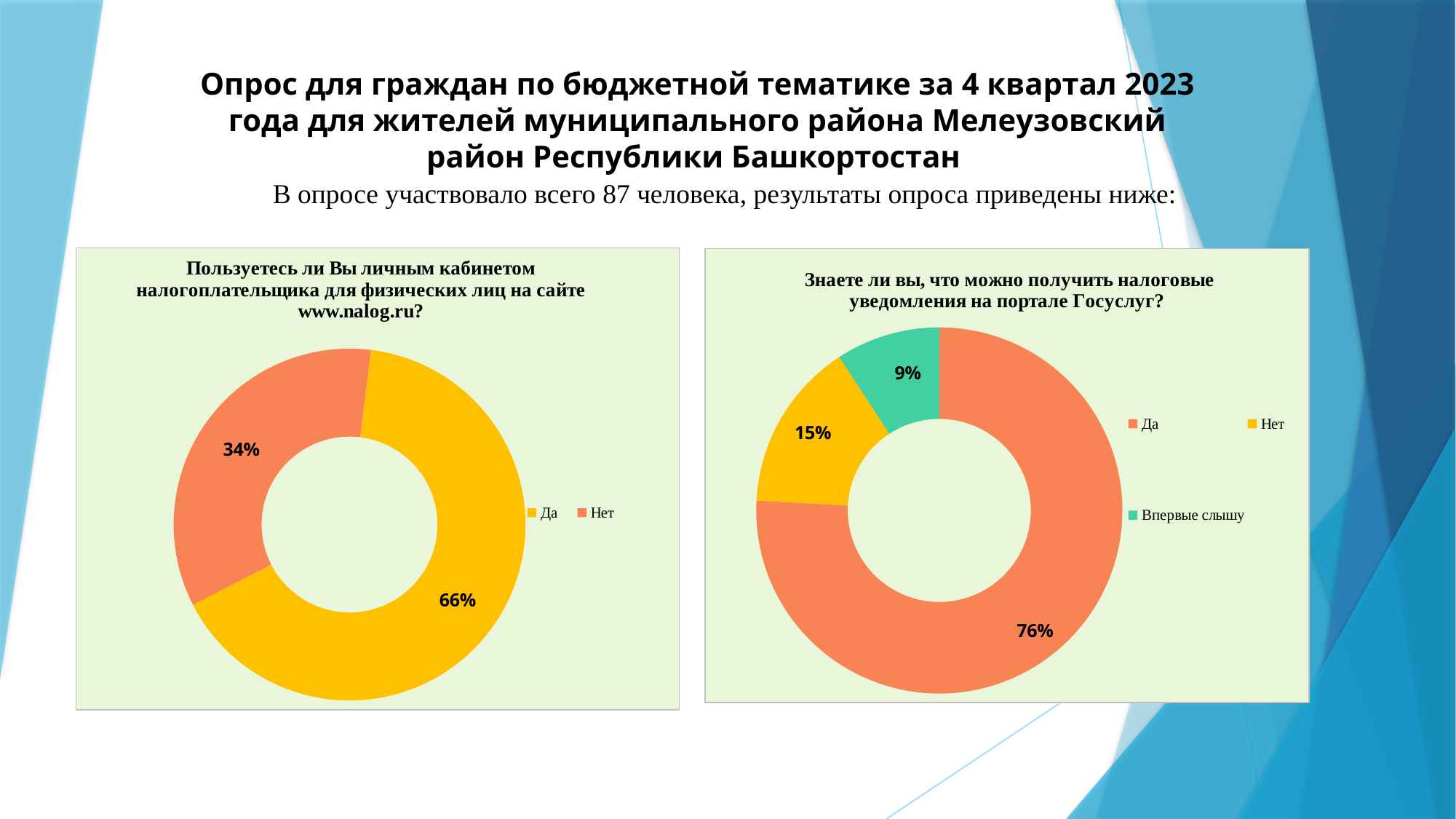
In the right chart, what share of respondents answered "Нет"? 15% How many categories does the legend of the right chart list? 3 In the right chart, which is larger: the share for "Нет" or for "Впервые слышу"? Нет In the left chart, which answer has the larger share? Да In the right chart, what is the difference between the "Да" and "Нет" shares? 61% In the left chart, what share of respondents answered "Нет"? 34% In the left chart, what is the difference between the "Да" and "Нет" shares? 32% In the right chart, which answer has the smallest share? Впервые слышу In the right chart, what share of respondents answered "Впервые слышу"? 9% In the left chart, what share of respondents answered "Да"? 66% What type of chart is the left chart? Doughnut chart In the right chart, what share of respondents answered "Да"? 76%